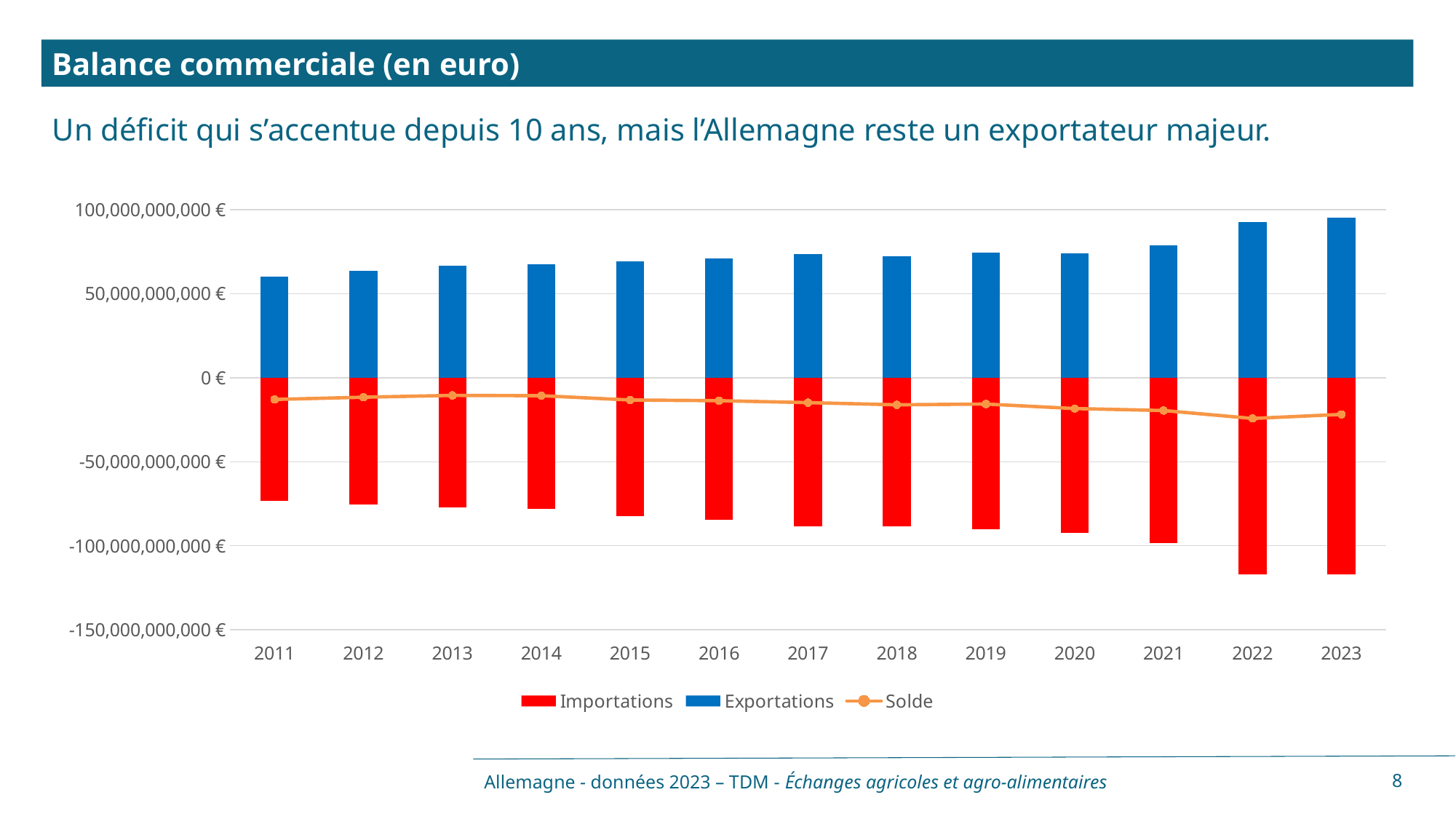
Which colour represents Importations in the chart? Red Is the Exportations value for 2011 greater or less than 100,000,000,000 €? less Do the Exportations values generally rise or fall from 2011 to 2023? rise What kind of chart is shown on the slide? Bar chart with a line Is the Exportations value for 2023 greater or less than 50,000,000,000 €? greater In which year is the Solde value the lowest (most negative)? 2022 How many series does the chart legend list? 3 How many years are shown on the x axis of the chart? 13 Is the Importations bar for 2011 above or below -100,000,000,000 €? above In which year is the Exportations value the lowest? 2011 Which year has the larger Exportations value, 2011 or 2023? 2023